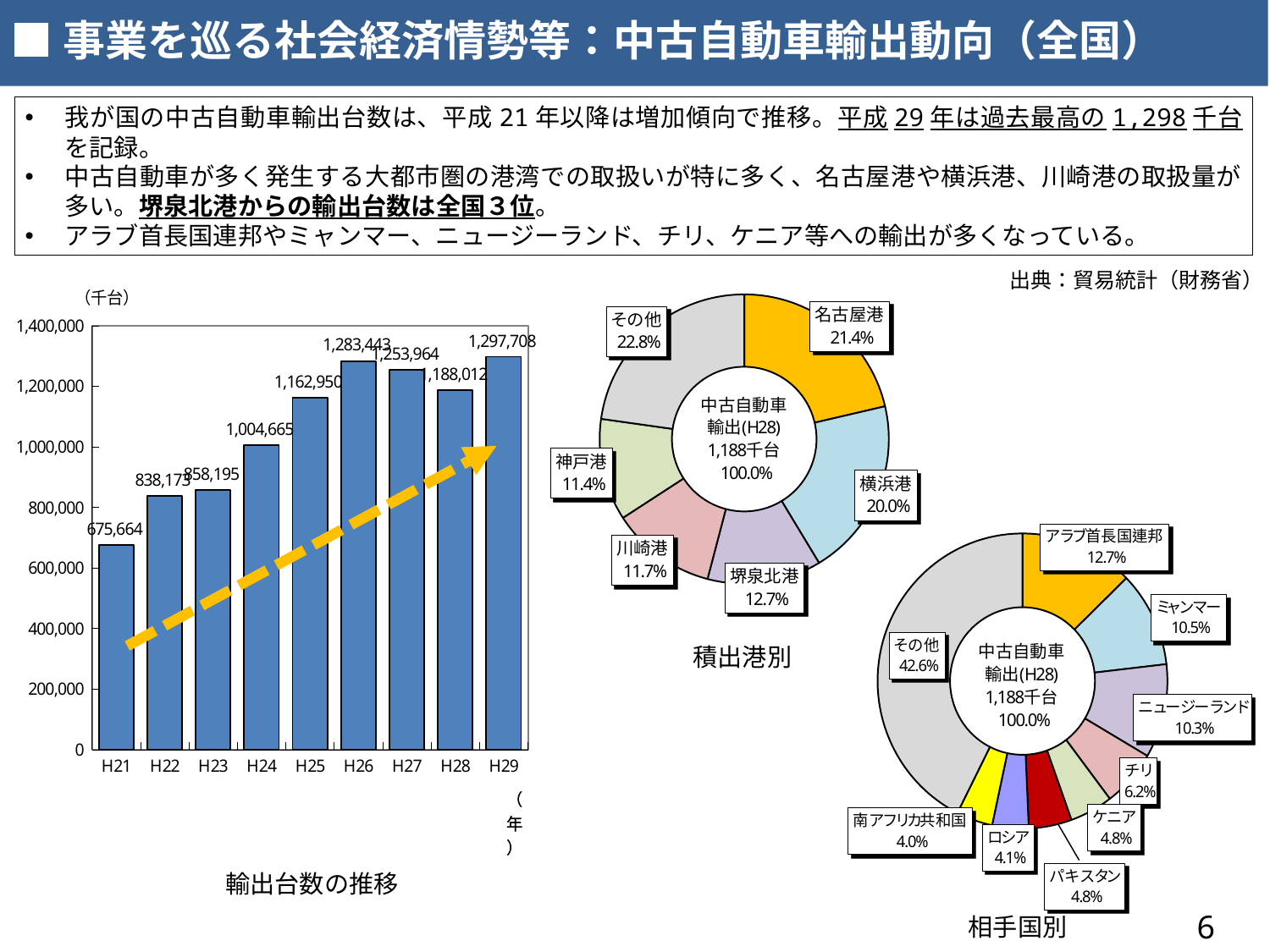
In the bar chart 輸出台数の推移, is the value for H25 greater or less than 1,000,000? greater In the 積出港別 chart, which named port has the smallest share? 神戸港 In the bar chart 輸出台数の推移, which is larger, H26 or H27? H26 In the 相手国別 chart, what share does ミャンマー have? 10.5% In the 積出港別 chart, what share does 名古屋港 have? 21.4% In the bar chart 輸出台数の推移, what is the value for H29? 1,297,708 In the bar chart 輸出台数の推移, what is the value for H24? 1,004,665 In the bar chart 輸出台数の推移, which year has the lowest value? H21 In the bar chart 輸出台数の推移, what is the value for H21? 675,664 In the bar chart 輸出台数の推移, how many years are plotted? 9 In the bar chart 輸出台数の推移, what is the difference between H29 and H21? 622,044 What kind of chart is 輸出台数の推移? bar chart